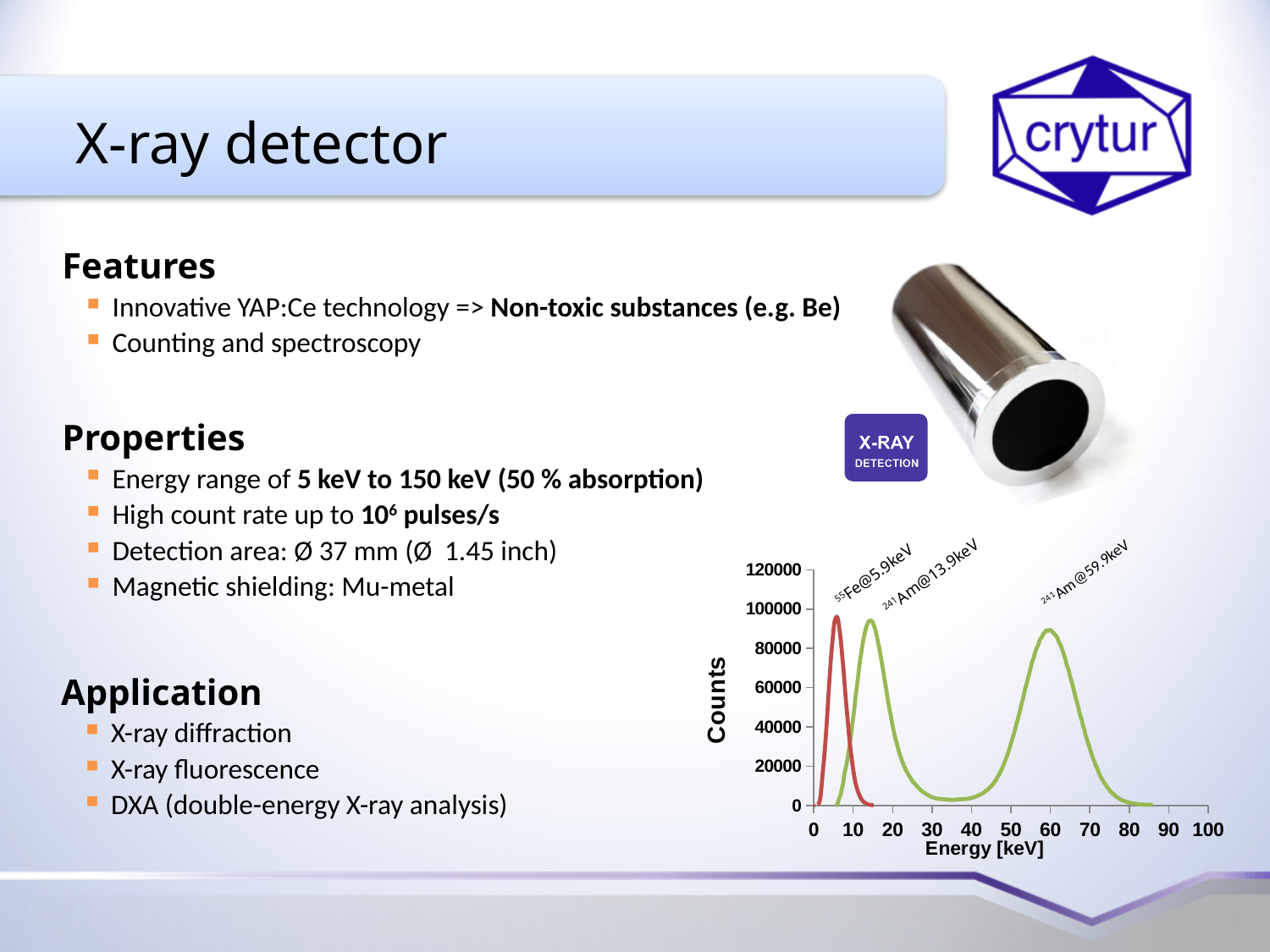
How many labelled peaks are shown in the chart? 3 What is the highest value shown on the y-axis of the chart? 120000 What kind of chart is shown on the slide? line chart Is the peak count for 241Am@59.9keV greater or less than 60000? greater What is the label of the y-axis of the chart? Counts Is the peak count for 55Fe@5.9keV greater or less than 80000? greater Which labelled peak occurs at the lowest energy? 55Fe@5.9keV Which labelled peak occurs at the highest energy? 241Am@59.9keV Is the peak count for 55Fe@5.9keV greater or less than 100000? less What is the label of the x-axis of the chart? Energy [keV]